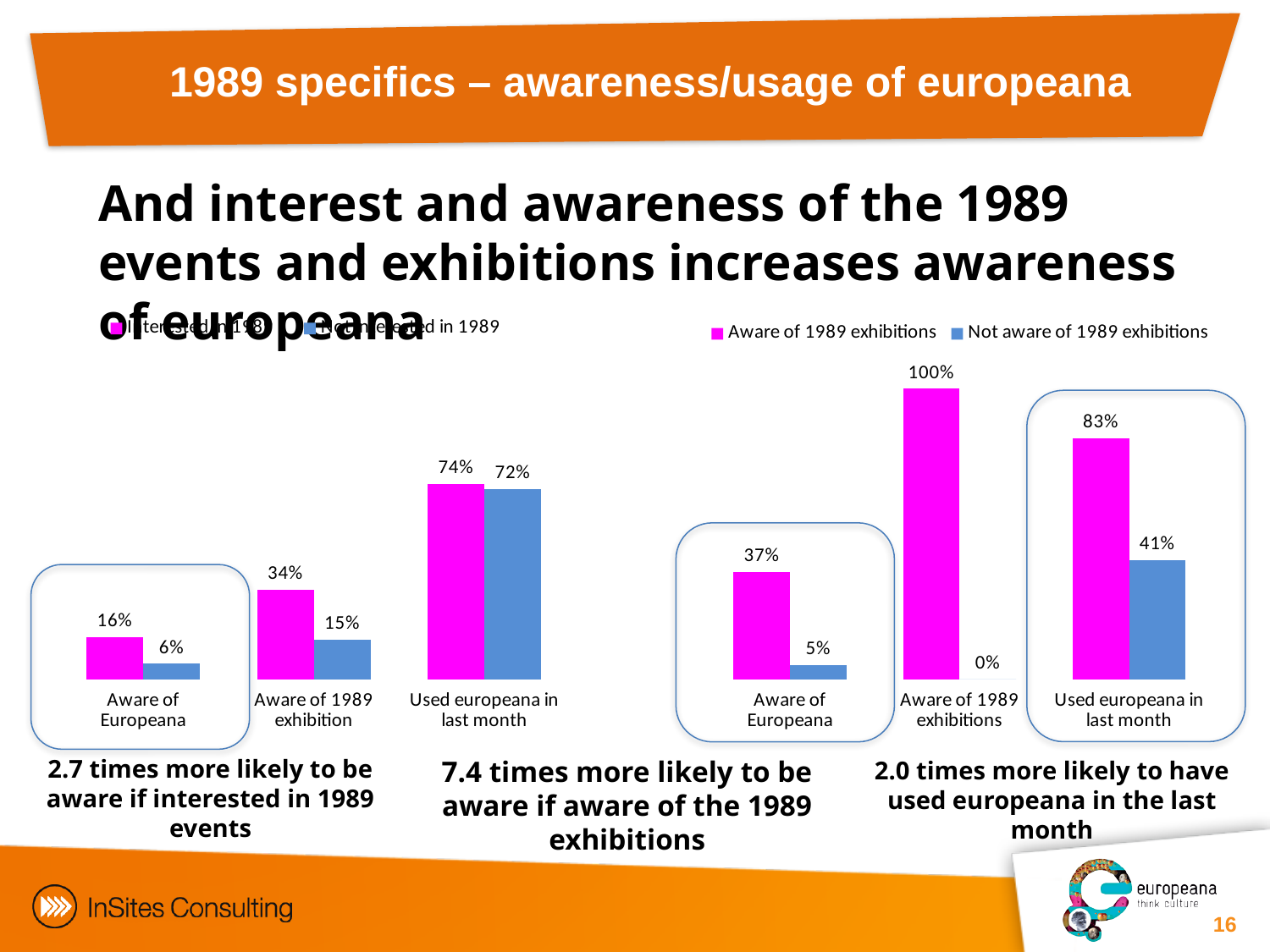
In the right chart, which category has the highest value for 'Aware of 1989 exhibitions'? Aware of 1989 exhibitions In the right chart, what is the value for 'Not aware of 1989 exhibitions' in the 'Used europeana in last month' category? 41% In the left chart, what is the value of the pink bar for 'Aware of 1989 exhibition'? 34% In the right chart, what is the difference between the 'Aware of 1989 exhibitions' and 'Not aware of 1989 exhibitions' values for 'Used europeana in last month'? 42% In the right chart, which category has the lowest value for 'Not aware of 1989 exhibitions'? Aware of 1989 exhibitions In the right chart, what is the value for 'Aware of 1989 exhibitions' in the 'Aware of Europeana' category? 37% In the left chart, which is larger for 'Used europeana in last month': the pink bar or the blue bar? the pink bar How many categories are shown on the x axis of the right chart? 3 In the left chart, what is the value of the blue bar for 'Aware of Europeana'? 6% How many series does the legend of the right chart list? 2 In the left chart, what is the difference between the pink and blue bars for 'Aware of 1989 exhibition'? 19% What kind of chart is the left chart? bar chart